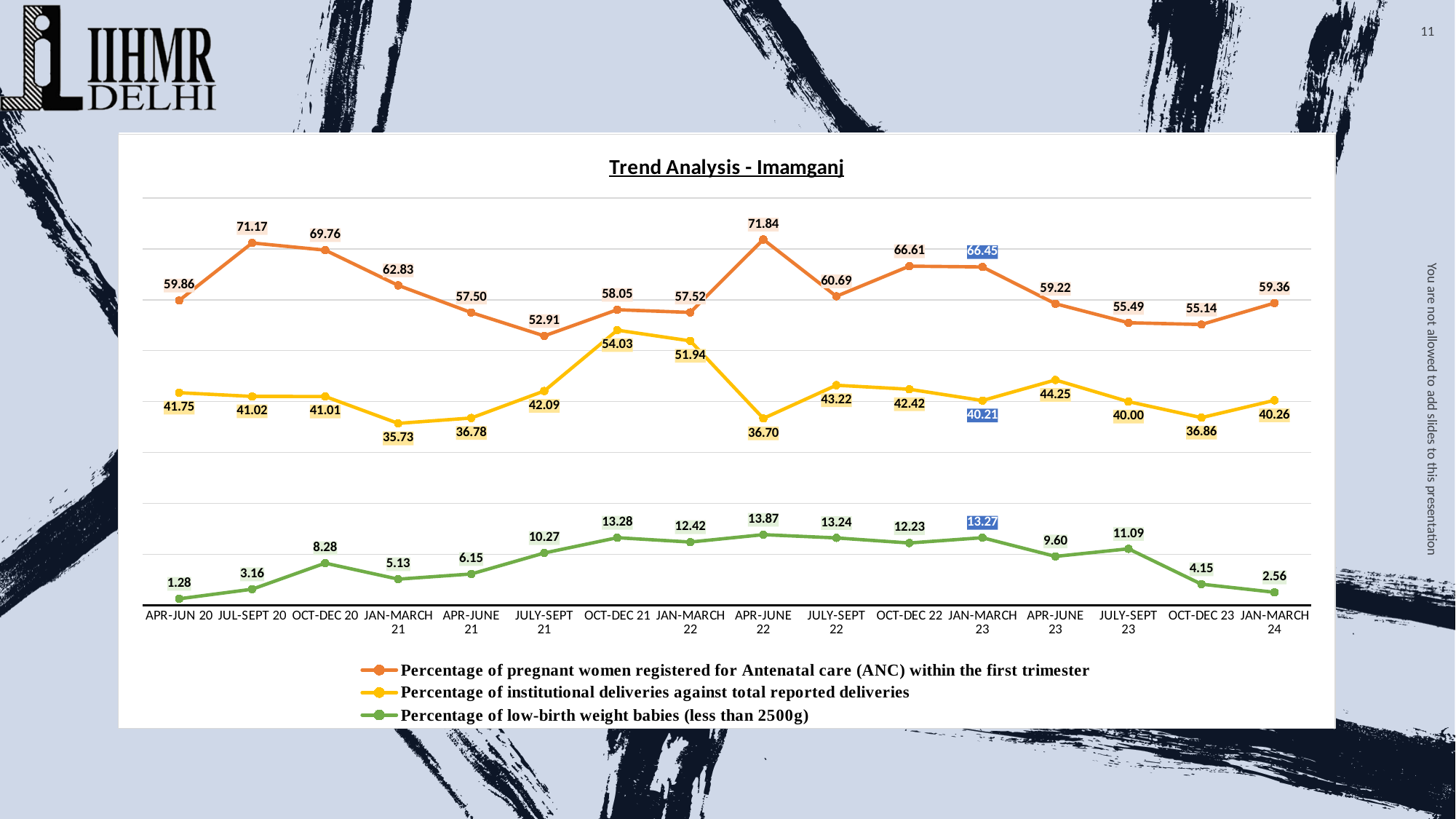
What is the percentage of low-birth weight babies in JAN-MARCH 24? 2.56 In which period is the percentage of institutional deliveries the lowest? JAN-MARCH 21 What is the percentage of pregnant women registered for ANC within the first trimester in APR-JUNE 22? 71.84 What is the title of the chart? Trend Analysis - Imamganj Which is larger: the percentage of institutional deliveries in APR-JUNE 23 or in OCT-DEC 23? APR-JUNE 23 In which period is the percentage of low-birth weight babies the lowest? APR-JUN 20 What is the difference between the ANC registration percentage in JUL-SEPT 20 and APR-JUN 20? 11.31 How many time periods are plotted along the x axis? 16 What type of chart is shown on the slide? Line chart What is the percentage of institutional deliveries against total reported deliveries in OCT-DEC 21? 54.03 How many series does the legend list? 3 In which period is the percentage of pregnant women registered for ANC within the first trimester the lowest? JULY-SEPT 21